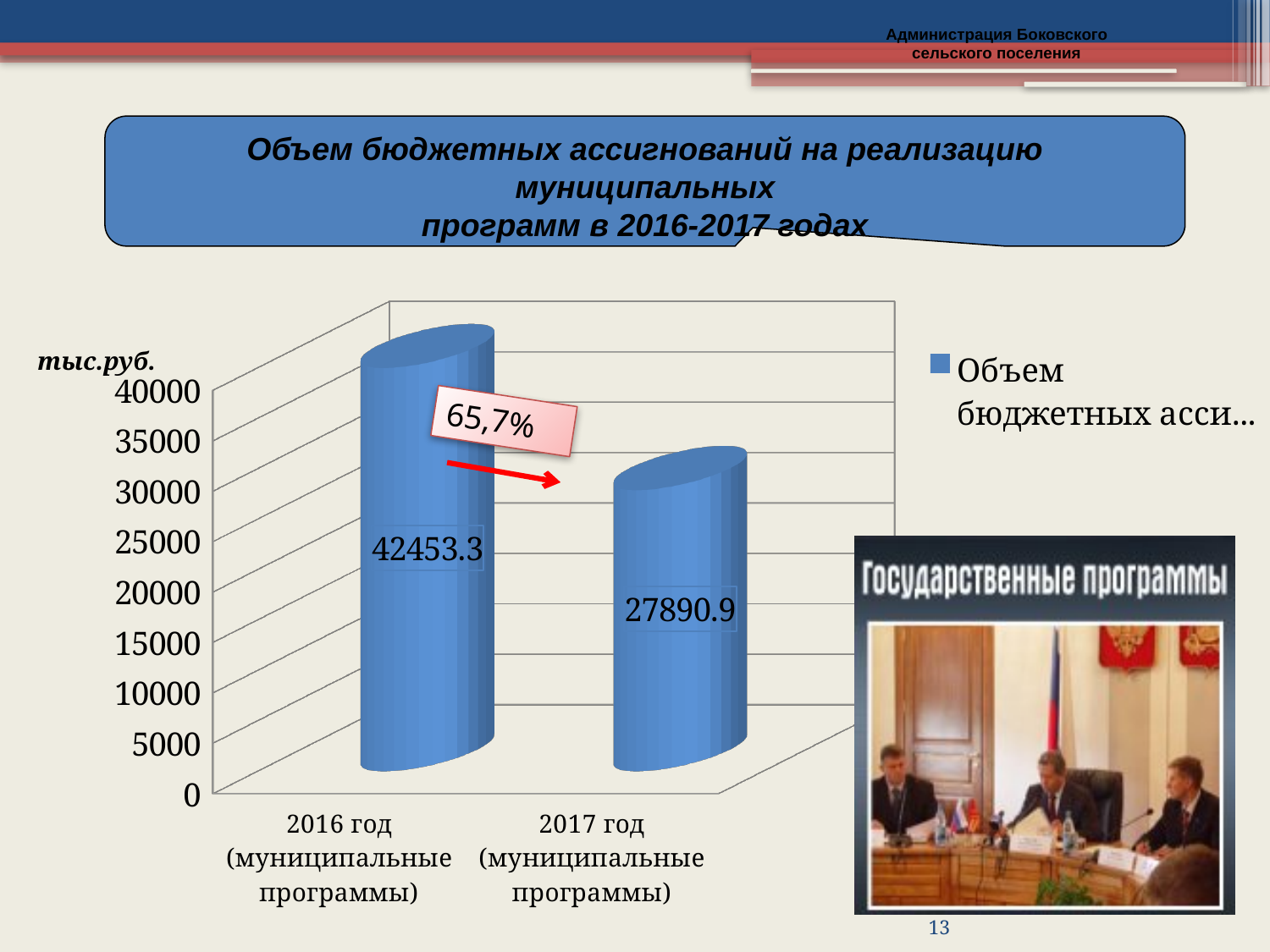
Do the values rise or fall from 2016 to 2017? fall What kind of chart is shown? bar chart Is the value for 2017 год greater or less than 30000? less How many categories are shown on the x axis? 2 Is the value for 2016 год greater or less than 40000? greater What is the difference between the 2016 and 2017 values? 14562.4 Which year has the lower value? 2017 год What unit is indicated next to the vertical axis? тыс.руб. What is the value for 2017 год (муниципальные программы)? 27890.9 What is the value for 2016 год (муниципальные программы)? 42453.3 Which year has the higher value? 2016 год What percentage is shown in the callout on the chart? 65,7%